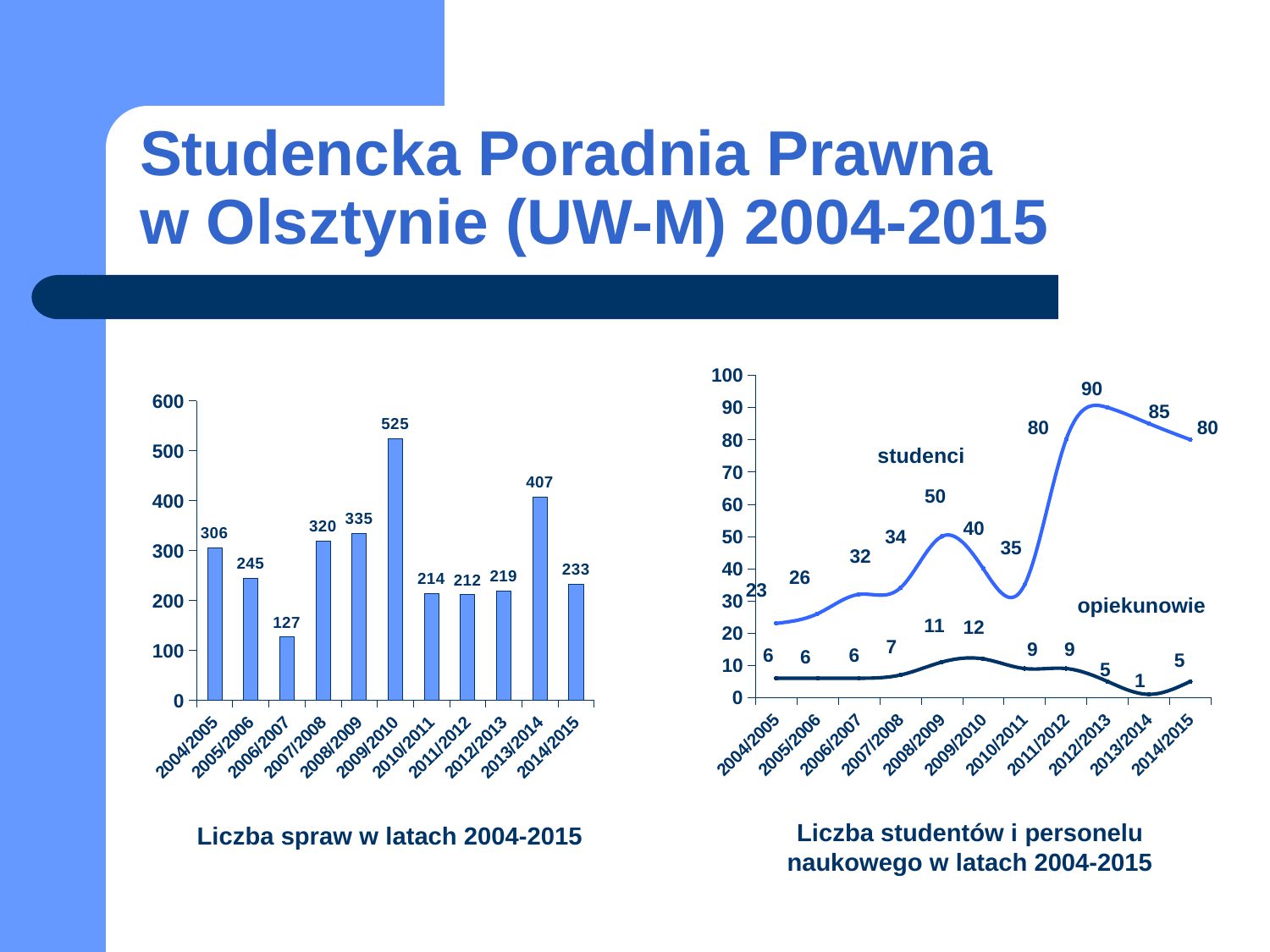
In the right chart (Liczba studentów i personelu naukowego), what is the value for opiekunowie in 2013/2014? 1 What kind of chart is the left chart (Liczba spraw w latach 2004-2015)? bar chart In the left chart (Liczba spraw w latach 2004-2015), which is larger, the value for 2007/2008 or 2008/2009? 2008/2009 How many bars are in the left chart (Liczba spraw w latach 2004-2015)? 11 In the left chart (Liczba spraw w latach 2004-2015), what is the difference between the values for 2013/2014 and 2014/2015? 174 In the right chart (Liczba studentów i personelu naukowego), does the studenci series rise or fall from 2010/2011 to 2012/2013? rise In the right chart (Liczba studentów i personelu naukowego), what is the value for studenci in 2012/2013? 90 In the left chart (Liczba spraw w latach 2004-2015), which year has the lowest value? 2006/2007 In the left chart (Liczba spraw w latach 2004-2015), what is the value for 2009/2010? 525 How many series are plotted in the right chart (Liczba studentów i personelu naukowego)? 2 What kind of chart is the right chart (Liczba studentów i personelu naukowego)? line chart In the right chart (Liczba studentów i personelu naukowego), what is the difference between studenci and opiekunowie in 2008/2009? 39